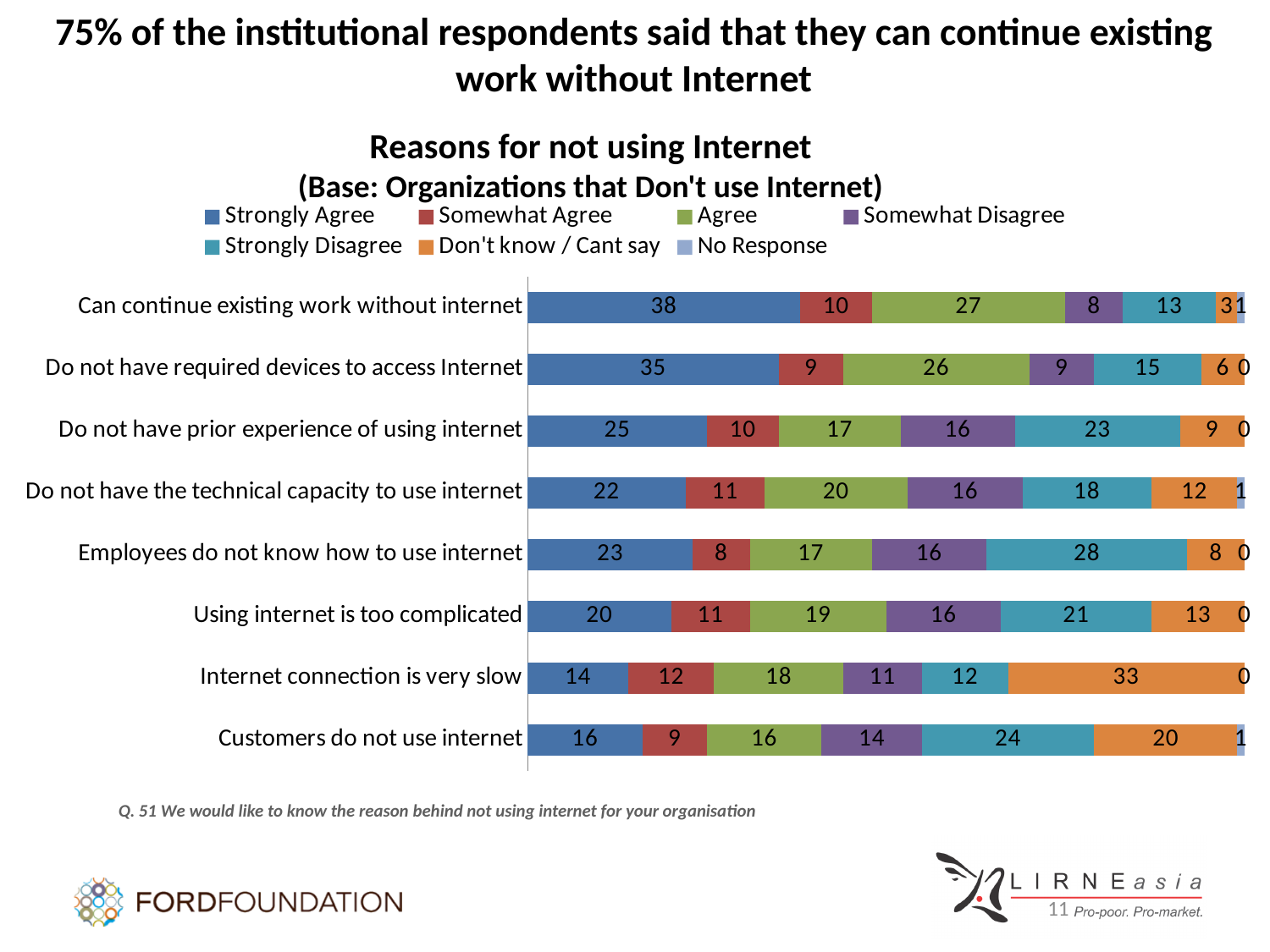
Which is larger: the Strongly Disagree value for "Customers do not use internet" or for "Do not have prior experience of using internet"? Customers do not use internet What is the difference between the Agree values for "Can continue existing work without internet" and "Do not have required devices to access Internet"? 1 What kind of chart is shown on the slide? Stacked bar chart What is the total of the stacked bar for "Internet connection is very slow"? 100 What is the Strongly Disagree value for "Employees do not know how to use internet"? 28 What is the Don't know / Cant say value for "Internet connection is very slow"? 33 Which category has the highest Strongly Agree value? Can continue existing work without internet Which category has the lowest Strongly Agree value? Internet connection is very slow What is the Strongly Agree value for "Can continue existing work without internet"? 38 How many categories (reasons) are shown in the chart? 8 How many series does the legend list? 7 Which legend entry is represented by the orange segments? Don't know / Cant say